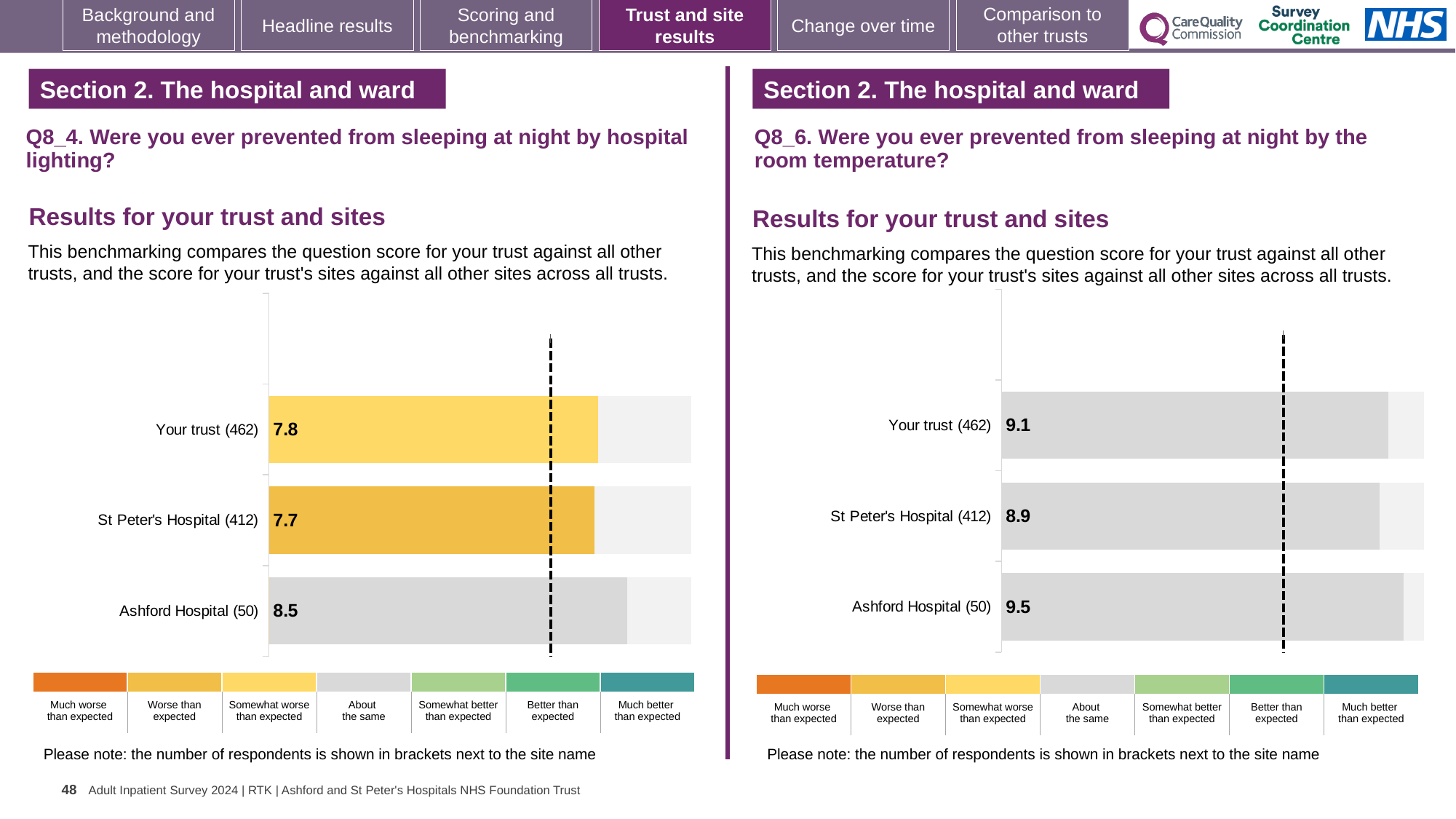
In the Q8_6 chart (room temperature), what is the score for Your trust? 9.1 In the Q8_4 chart (hospital lighting), what is the score for St Peter's Hospital? 7.7 In the Q8_4 chart (hospital lighting), what is the score for Your trust? 7.8 What kind of chart is used on the left side of the slide for Q8_4? Bar chart In the Q8_6 chart (room temperature), what is the difference between the Your trust score and the St Peter's Hospital score? 0.2 In the Q8_4 chart (hospital lighting), which site or trust has the highest score? Ashford Hospital In the Q8_6 chart (room temperature), which site or trust has the lowest score? St Peter's Hospital In the Q8_6 chart (room temperature), is the score for Ashford Hospital or St Peter's Hospital larger? Ashford Hospital In the Q8_4 chart (hospital lighting), what is the difference between the Ashford Hospital score and the St Peter's Hospital score? 0.8 In the Q8_4 chart (hospital lighting), how many bars are plotted? 3 In the Q8_4 chart (hospital lighting), how many respondents are shown in brackets for Ashford Hospital? 50 In the Q8_6 chart (room temperature), what is the score for Ashford Hospital? 9.5